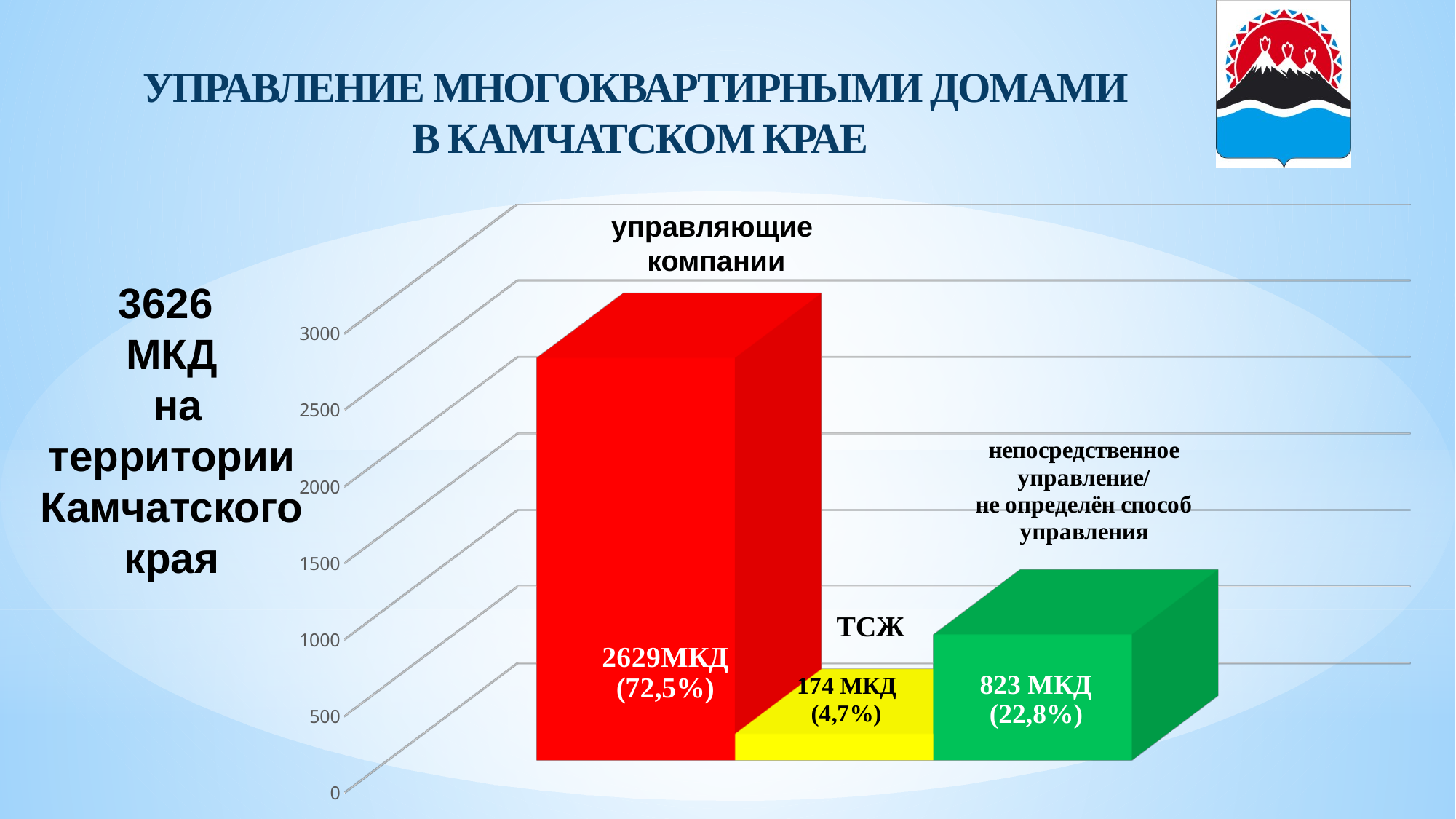
What is the total number of МКД on the territory of Камчатский край stated on the slide? 3626 How many management categories are shown in the chart? 3 What is the difference in МКД between непосредственное управление / не определён способ управления and ТСЖ? 649 Which management category has the lowest number of МКД? ТСЖ Which management category has the highest number of МКД? управляющие компании How many МКД are managed by ТСЖ? 174 Which has more МКД: ТСЖ or непосредственное управление / не определён способ управления? непосредственное управление / не определён способ управления How many multi-apartment buildings (МКД) are managed by управляющие компании? 2629 What is the difference in МКД between управляющие компании and непосредственное управление / не определён способ управления? 1806 Is the value for управляющие компании greater or less than 2500? greater What type of chart is shown on the slide? bar chart What percentage share is shown for непосредственное управление / не определён способ управления? 22,8%